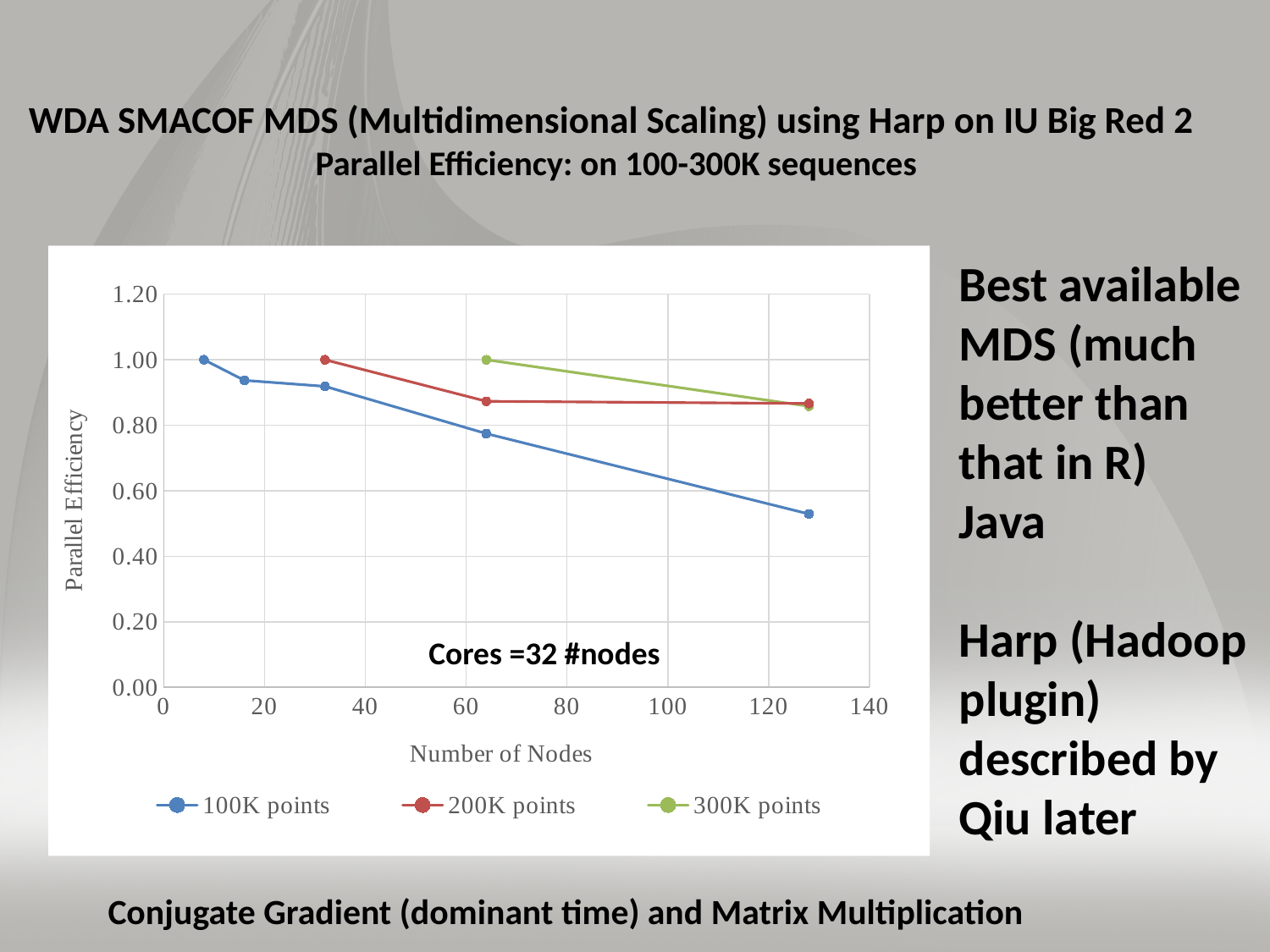
How many data points are plotted for the 100K points series? 5 Is the parallel efficiency of the 200K points series at its rightmost point (about 128 nodes) greater or less than 0.80? greater How many series does the chart legend list? 3 What is the highest parallel efficiency value reached by the 100K points series? 1.00 Does the parallel efficiency of the 100K points series rise or fall as the number of nodes increases? fall What is the label of the x axis of the chart? Number of Nodes What kind of chart is shown on the slide? line chart Which series has the lowest parallel efficiency at the rightmost point (about 128 nodes)? 100K points At the rightmost point (about 128 nodes), which series has the higher parallel efficiency: 100K points or 200K points? 200K points What is the label of the y axis of the chart? Parallel Efficiency Is the parallel efficiency of the 100K points series at its rightmost point (about 128 nodes) greater or less than 0.60? less How many data points are plotted for the 300K points series? 2